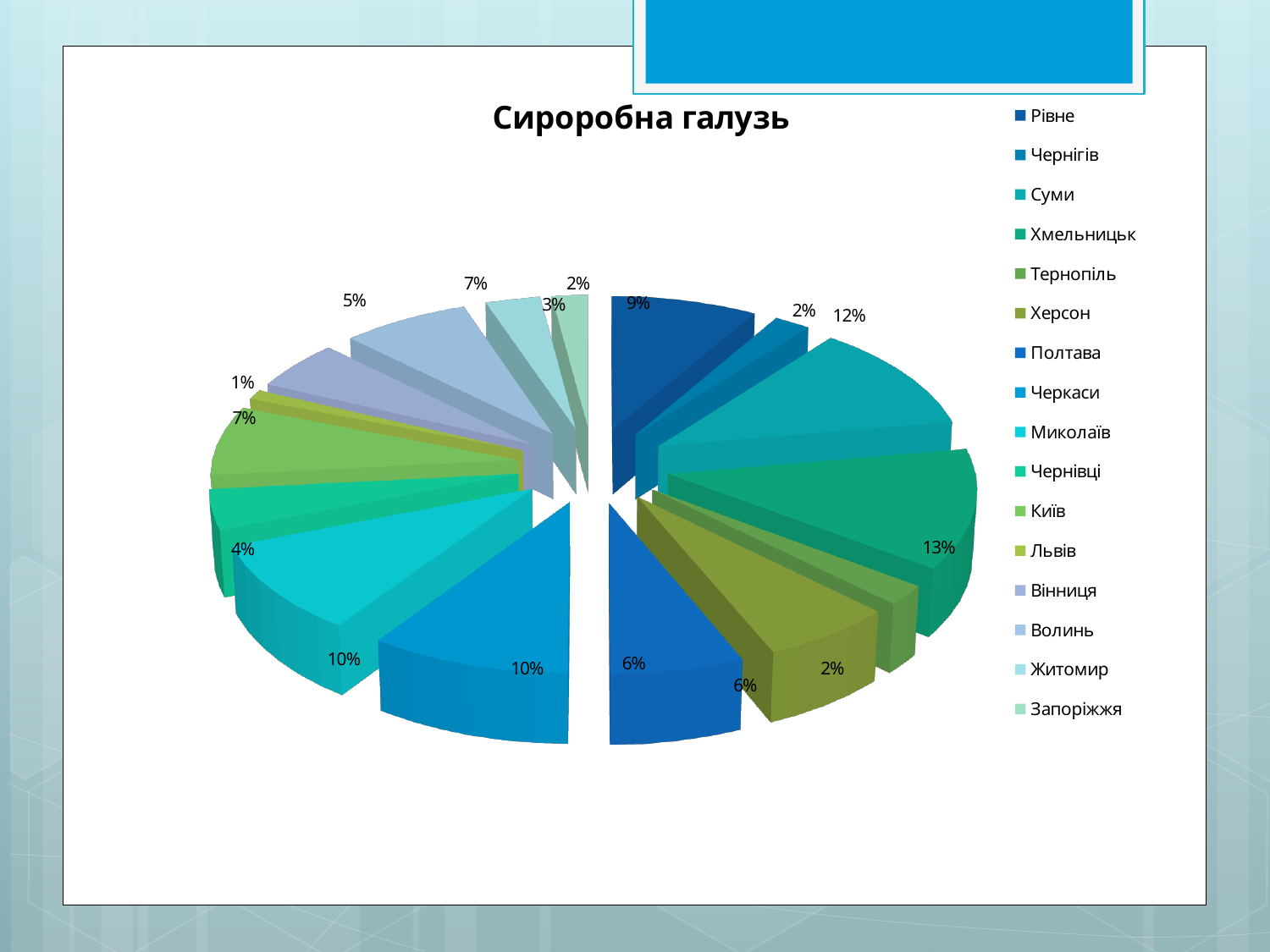
What share of the pie does Рівне have? 9% What share of the pie does Львів have? 1% Which category is listed first in the legend? Рівне What share of the pie does Суми have? 12% Which has a larger share, Суми or Рівне? Суми Which category has the smallest share of the pie? Львів What is the title of the chart? Сироробна галузь What is the difference in percentage points between the shares of Хмельницьк and Рівне? 4 What kind of chart is shown on the slide? pie chart Which category has the largest share of the pie? Хмельницьк How many categories does the legend of the pie chart list? 16